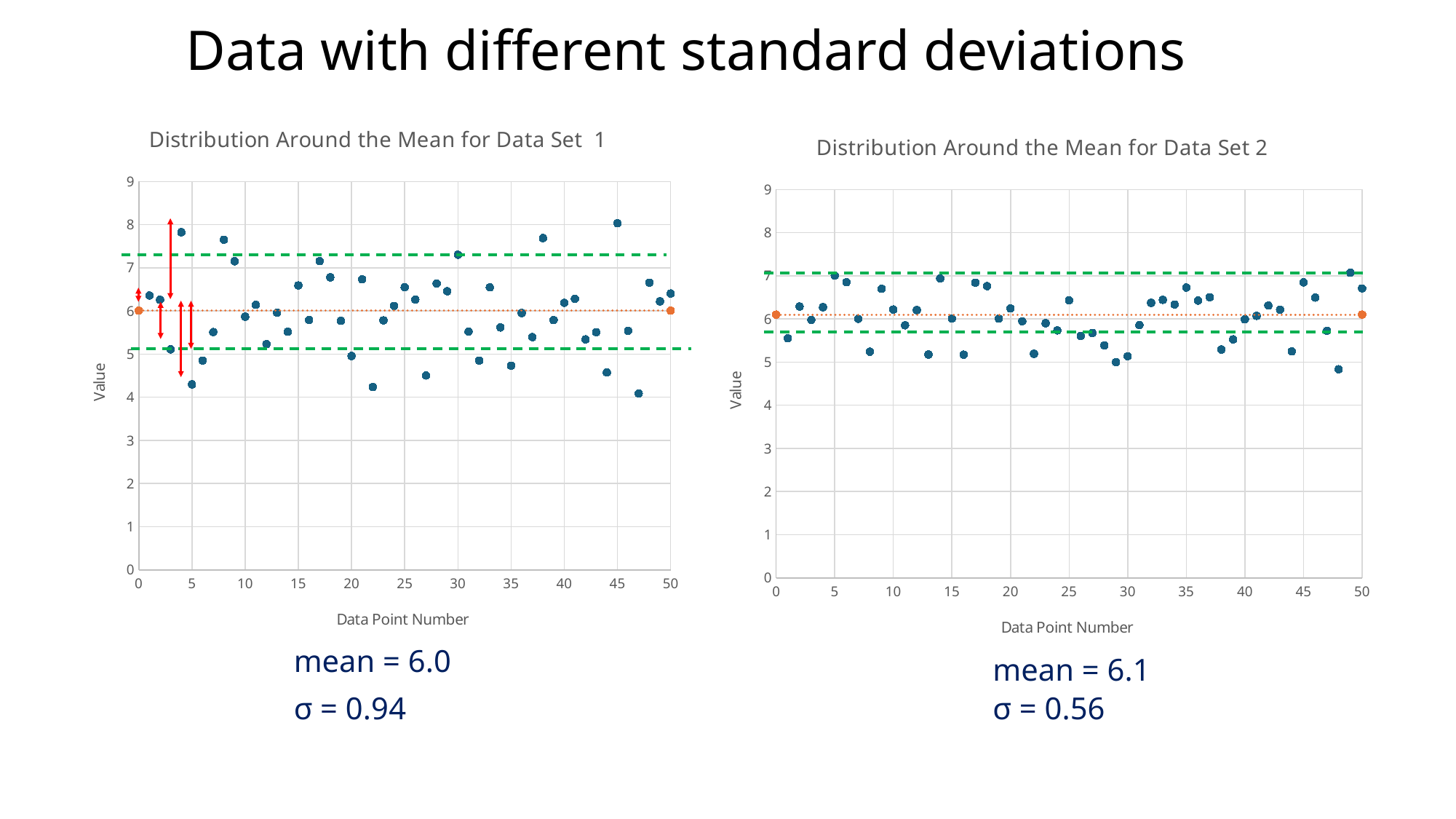
What kind of chart is "Distribution Around the Mean for Data Set 2"? scatter chart In the chart "Distribution Around the Mean for Data Set 1", what is the mean stated below the chart? 6.0 In the chart "Distribution Around the Mean for Data Set 2", what is the mean stated below the chart? 6.1 In the chart "Distribution Around the Mean for Data Set 2", is the value at data point number 48 greater or less than 5? less In the chart "Distribution Around the Mean for Data Set 2", what is the label of the x axis? Data Point Number In the chart "Distribution Around the Mean for Data Set 1", is the value at data point number 4 greater or less than 7? greater In the chart "Distribution Around the Mean for Data Set 1", is the value at data point number 5 greater or less than 5? less In the chart "Distribution Around the Mean for Data Set 1", which has the larger value: data point number 4 or data point number 5? data point number 4 In the chart "Distribution Around the Mean for Data Set 1", what is the standard deviation (σ) stated below the chart? 0.94 In the chart "Distribution Around the Mean for Data Set 2", what is the standard deviation (σ) stated below the chart? 0.56 Which chart has the larger standard deviation, Data Set 1 or Data Set 2? Data Set 1 What kind of chart is "Distribution Around the Mean for Data Set 1"? scatter chart